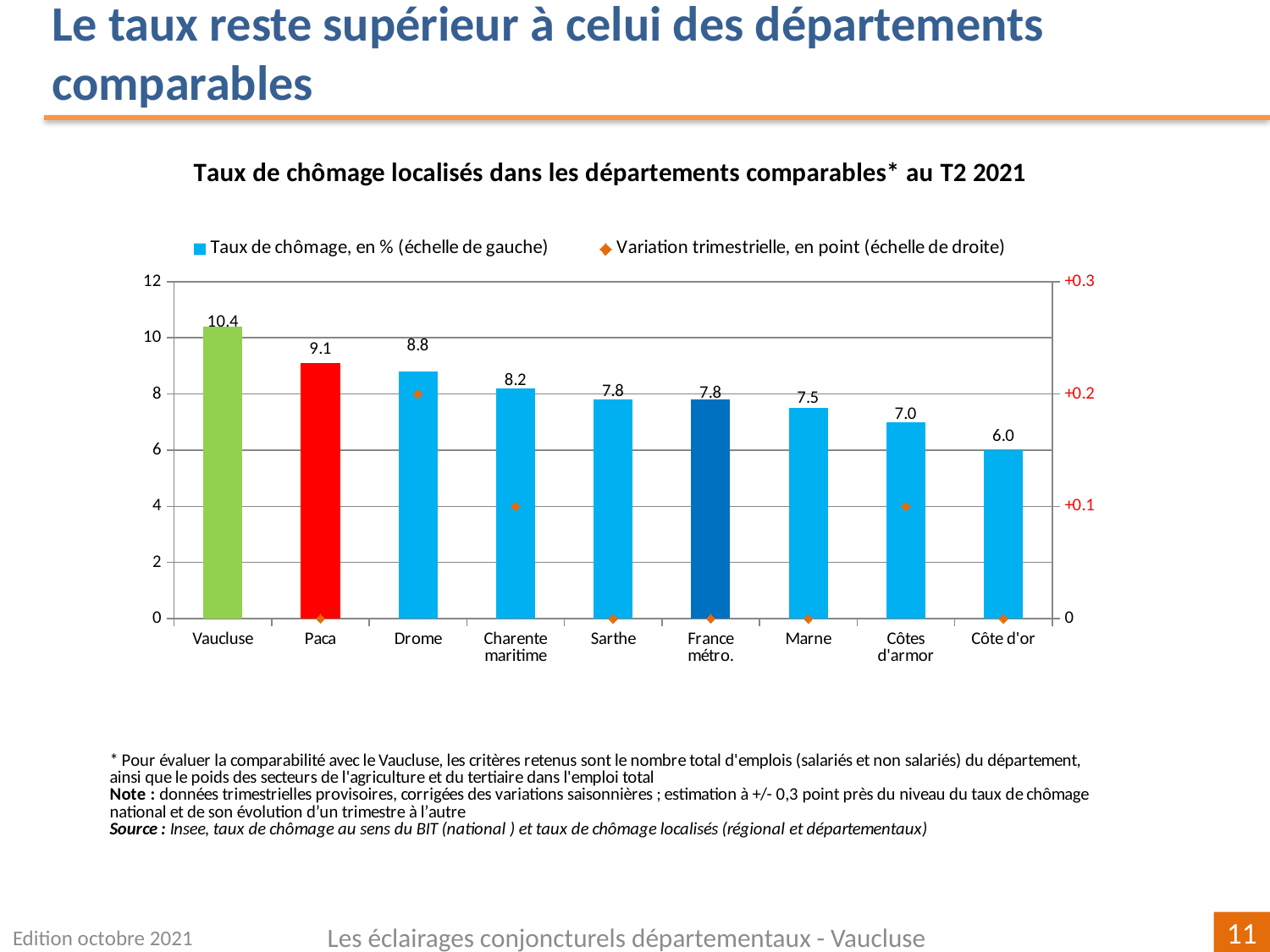
What is the unemployment rate (taux de chômage) shown for Vaucluse? 10.4 How many series does the legend list? 2 How many categories (départements/regions) are shown on the x axis? 9 Which category has the highest unemployment rate? Vaucluse What kind of chart is used to show the unemployment rates? Bar chart What is the difference between the unemployment rates of Vaucluse and Paca? 1.3 What is the quarterly variation (variation trimestrielle) shown for Drome on the right-hand scale? +0.2 Which has a higher unemployment rate, Drome or Marne? Drome Do the unemployment rate bars rise or fall from left to right along the x axis? Fall What is the unemployment rate shown for Côtes d'armor? 7.0 What is the unemployment rate shown for France métro.? 7.8 Which category has the lowest unemployment rate? Côte d'or